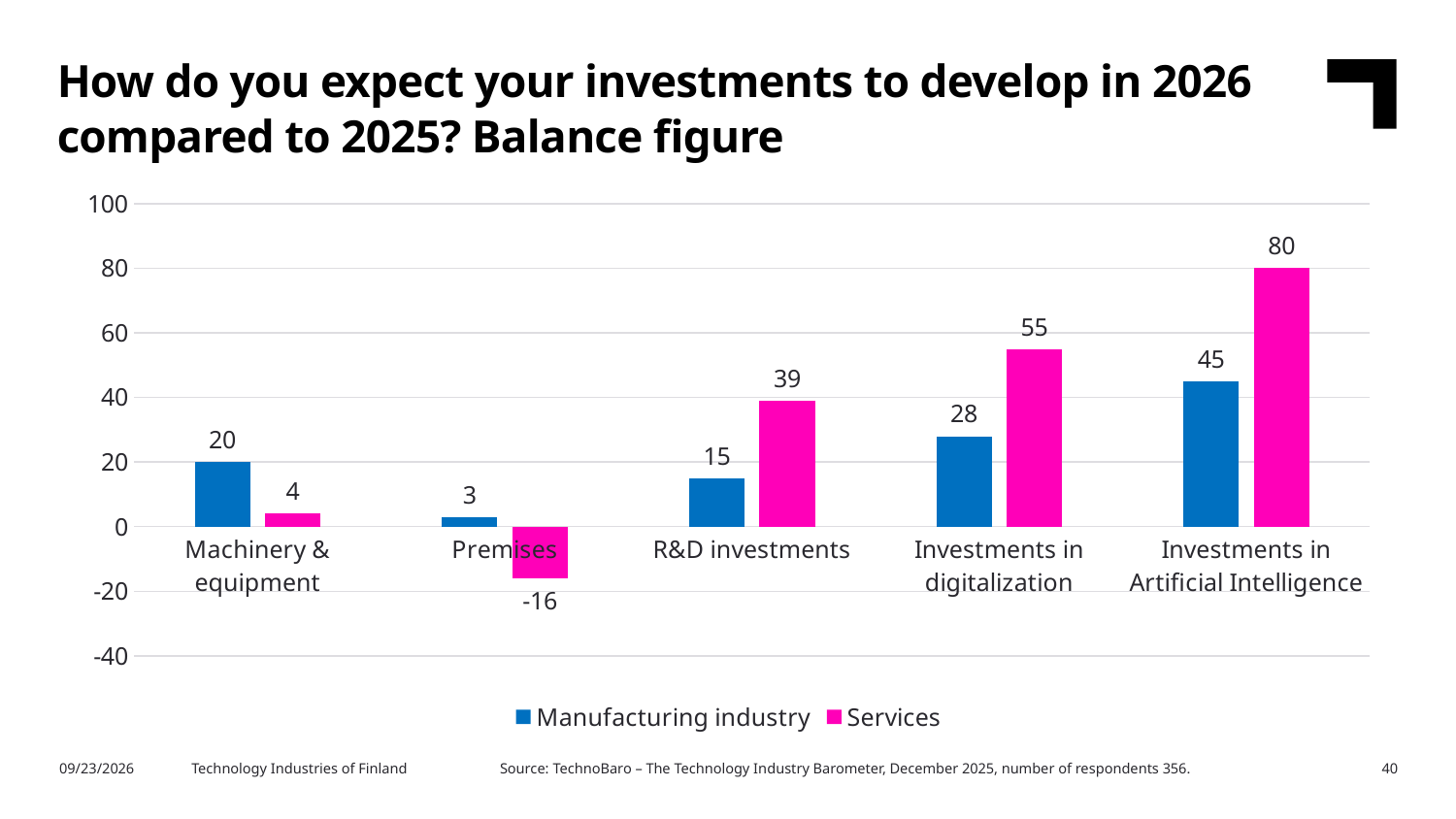
What kind of chart is shown on the slide? Bar chart What is the Services balance figure for Investments in Artificial Intelligence? 80 Which category has the lowest Manufacturing industry balance figure? Premises For Investments in digitalization, which series has the larger balance figure, Manufacturing industry or Services? Services Which category has the highest Services balance figure? Investments in Artificial Intelligence What is the difference between the Services and Manufacturing industry balance figures for R&D investments? 24 Is the Manufacturing industry balance figure for Investments in Artificial Intelligence greater or less than 40? greater What is the Services balance figure for Premises? -16 How many series does the legend list? 2 Which colour represents the Services series? Magenta (pink) What is the Manufacturing industry balance figure for Machinery & equipment? 20 How many investment categories are shown on the x axis? 5